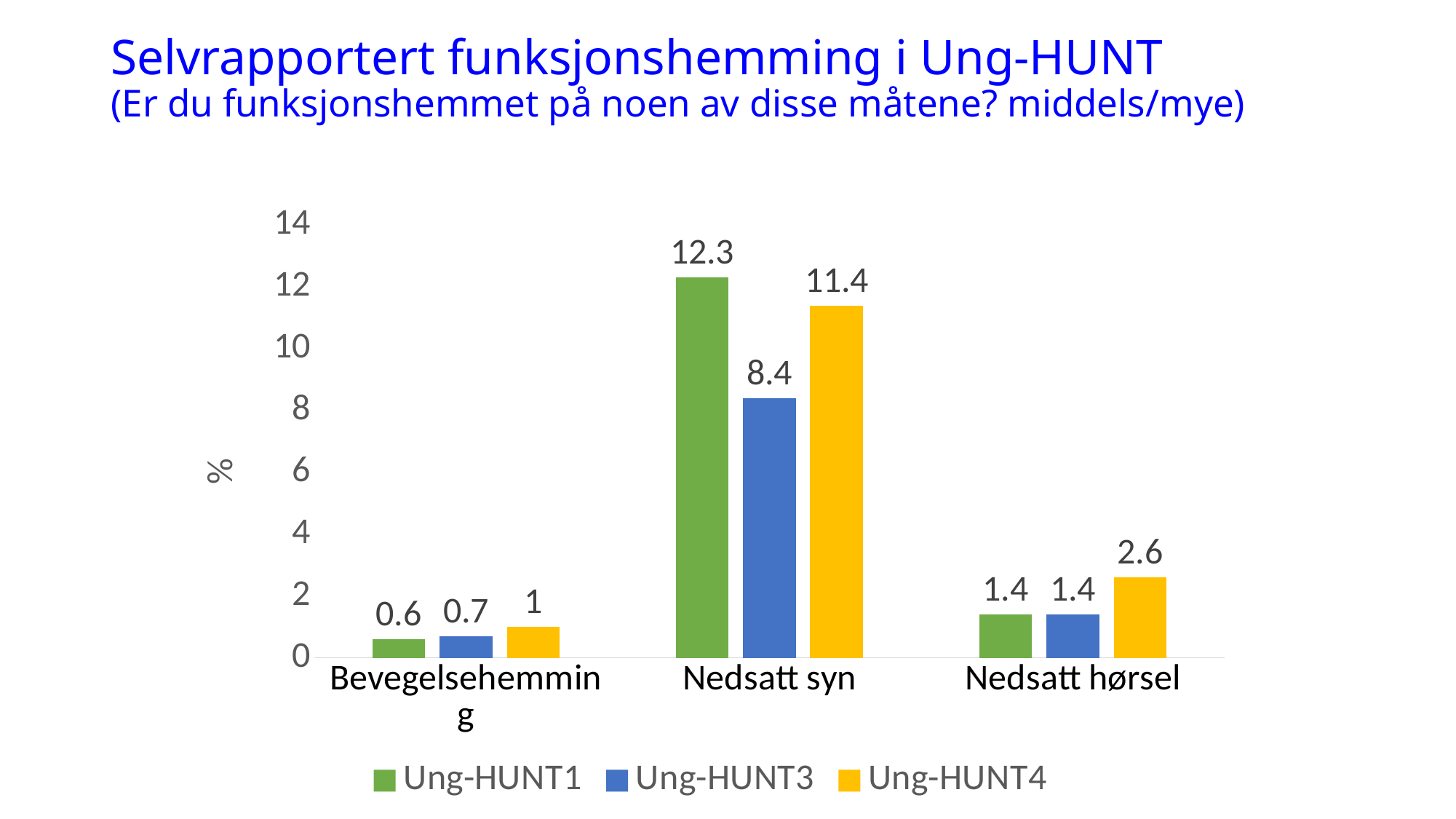
Which category has the lowest value for Ung-HUNT1? Bevegelsehemming What is the value for Ung-HUNT1 in the Nedsatt syn category? 12.3 What is the value for Ung-HUNT3 in the Bevegelsehemming category? 0.7 Which category has the highest value for Ung-HUNT3? Nedsatt syn What is the difference between the Ung-HUNT1 and Ung-HUNT3 values in the Nedsatt syn category? 3.9 How many series does the legend list? 3 Is the value for Ung-HUNT3 in the Nedsatt syn category greater or less than 10? less How many categories are shown on the x axis? 3 What is the value for Ung-HUNT4 in the Nedsatt hørsel category? 2.6 What kind of chart is shown on the slide? Bar chart What is the label on the vertical axis? % Which is larger in the Nedsatt syn category: Ung-HUNT1 or Ung-HUNT4? Ung-HUNT1